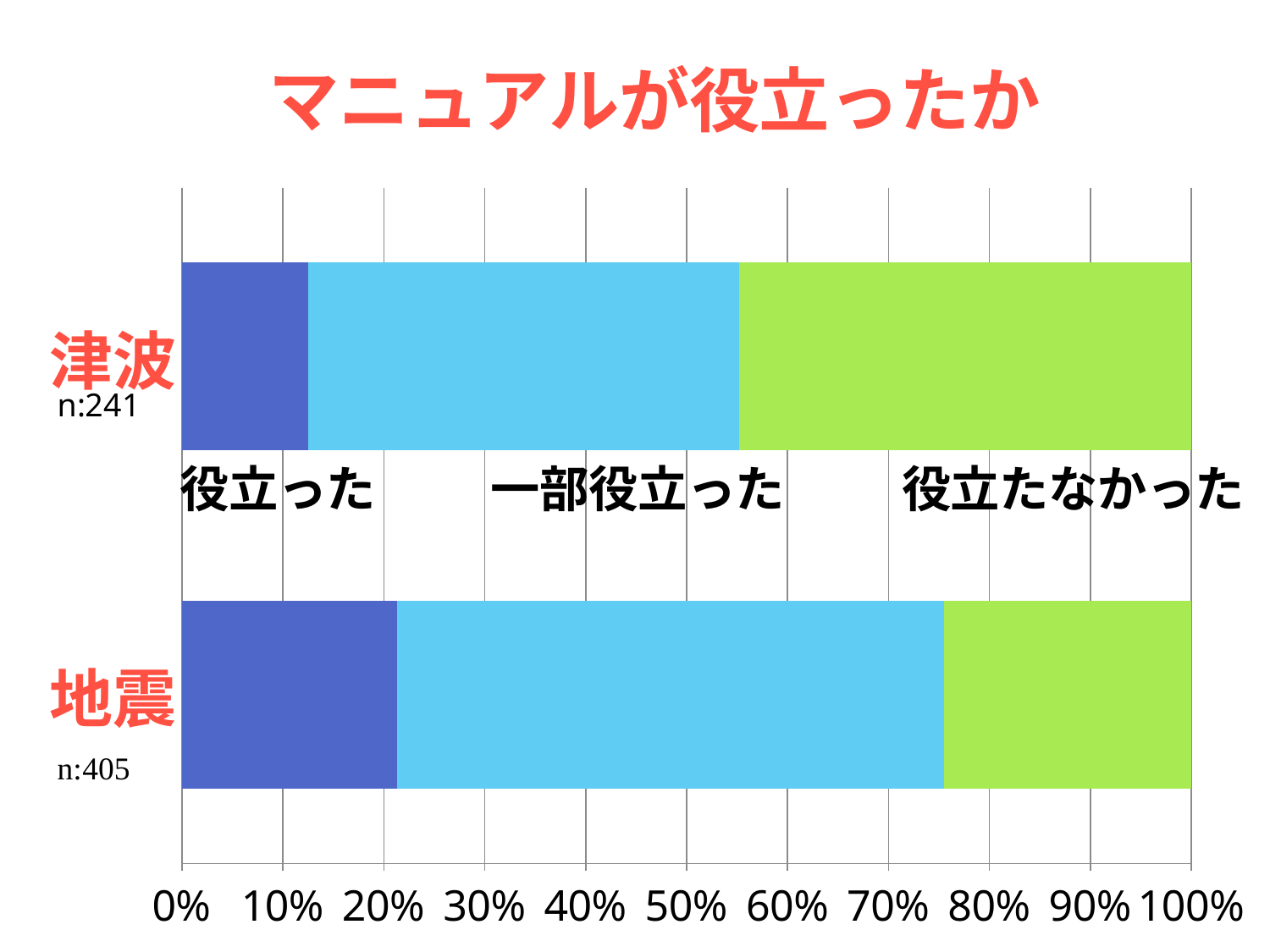
Is the 役立った share for 津波 greater or less than 20%? less What is the title of the chart? マニュアルが役立ったか Is the 役立たなかった share for 地震 greater or less than 30%? less For 地震, which response option has the largest share? 一部役立った Which category has the larger 役立たなかった share, 津波 or 地震? 津波 Is the 役立った share for 地震 greater or less than 10%? greater How many series (response options) are shown in the stacked bars? 3 Which category has the larger 役立った share, 津波 or 地震? 地震 What is the sample size (n) shown for 津波? n:241 How many categories (bars) does the chart show? 2 What kind of chart is shown on the slide? Stacked bar chart